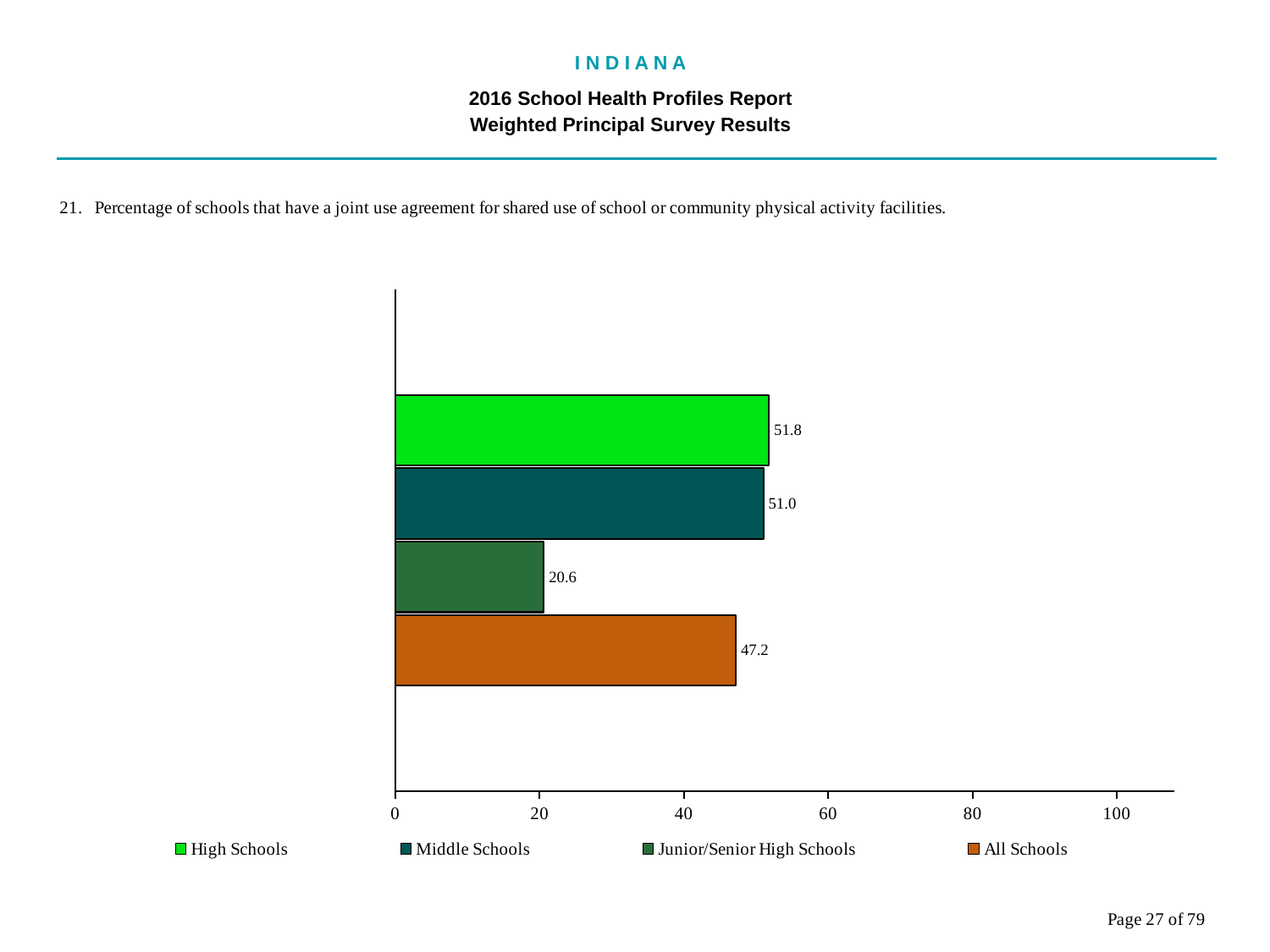
What is the difference between the values for High Schools and Junior/Senior High Schools? 31.2 What kind of chart is shown on the slide? bar chart What is the difference between the values for Middle Schools and All Schools? 3.8 Is the value for All Schools greater or less than 40? greater How many bars are shown in the chart? 4 What is the value for All Schools? 47.2 What is the value for Middle Schools? 51.0 What is the value for High Schools? 51.8 Which category has the highest value? High Schools Which is larger, the value for All Schools or the value for Junior/Senior High Schools? All Schools What is the value for Junior/Senior High Schools? 20.6 Which category has the lowest value? Junior/Senior High Schools